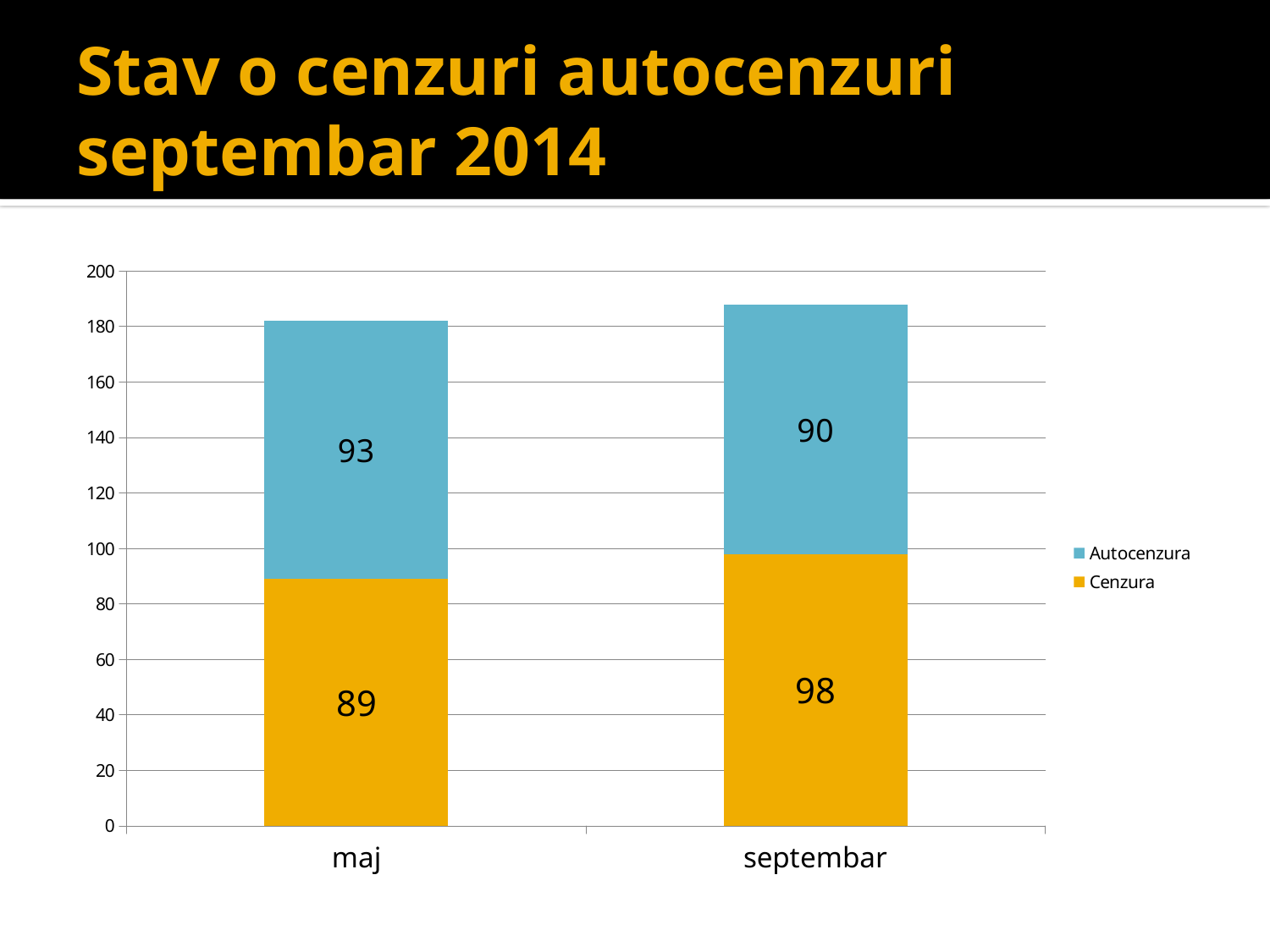
Which category has the higher Cenzura value, maj or septembar? septembar How many series does the legend list? 2 How many categories are shown on the x axis? 2 What kind of chart is shown on the slide? stacked bar chart What is the Cenzura value for septembar? 98 What is the Autocenzura value for maj? 93 What is the Autocenzura value for septembar? 90 What is the Cenzura value for maj? 89 What is the total of the stacked bar for septembar? 188 What is the difference between the Cenzura values for septembar and maj? 9 Which category has the lower Autocenzura value? septembar What is the total of the stacked bar for maj? 182